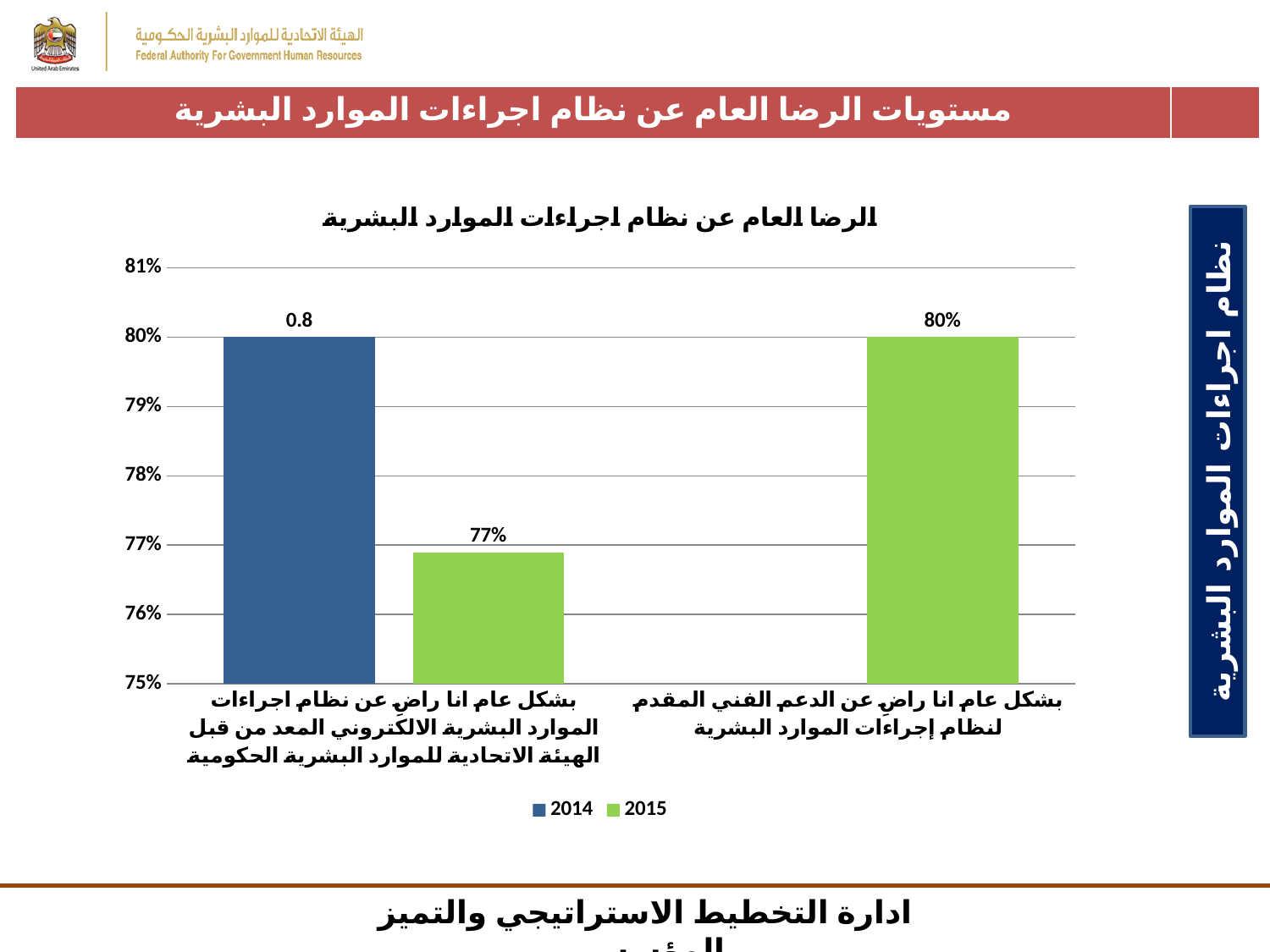
What is the value of the 2014 bar for the category "بشكل عام انا راضٍ عن نظام اجراءات الموارد البشرية الالكتروني المعد من قبل الهيئة الاتحادية للموارد البشرية الحكومية"? 0.8 How many categories are shown on the x axis? 2 Which category has the lower 2015 value? بشكل عام انا راضٍ عن نظام اجراءات الموارد البشرية الالكتروني المعد من قبل الهيئة الاتحادية للموارد البشرية الحكومية Is the 2015 value for "بشكل عام انا راضٍ عن نظام اجراءات الموارد البشرية الالكتروني المعد من قبل الهيئة الاتحادية للموارد البشرية الحكومية" greater or less than 78%? less What is the title of the chart? الرضا العام عن نظام اجراءات الموارد البشرية What is the 2015 value for the category "بشكل عام انا راضٍ عن الدعم الفني المقدم لنظام إجراءات الموارد البشرية"? 80% What is the 2015 value for the category "بشكل عام انا راضٍ عن نظام اجراءات الموارد البشرية الالكتروني المعد من قبل الهيئة الاتحادية للموارد البشرية الحكومية"? 77% Which colour represents the 2015 series in the legend? Green What is the difference between the 2015 values of the two categories? 3 percentage points What kind of chart is shown on the slide? Bar chart How many series does the legend list? 2 Which category has the higher 2015 value? بشكل عام انا راضٍ عن الدعم الفني المقدم لنظام إجراءات الموارد البشرية